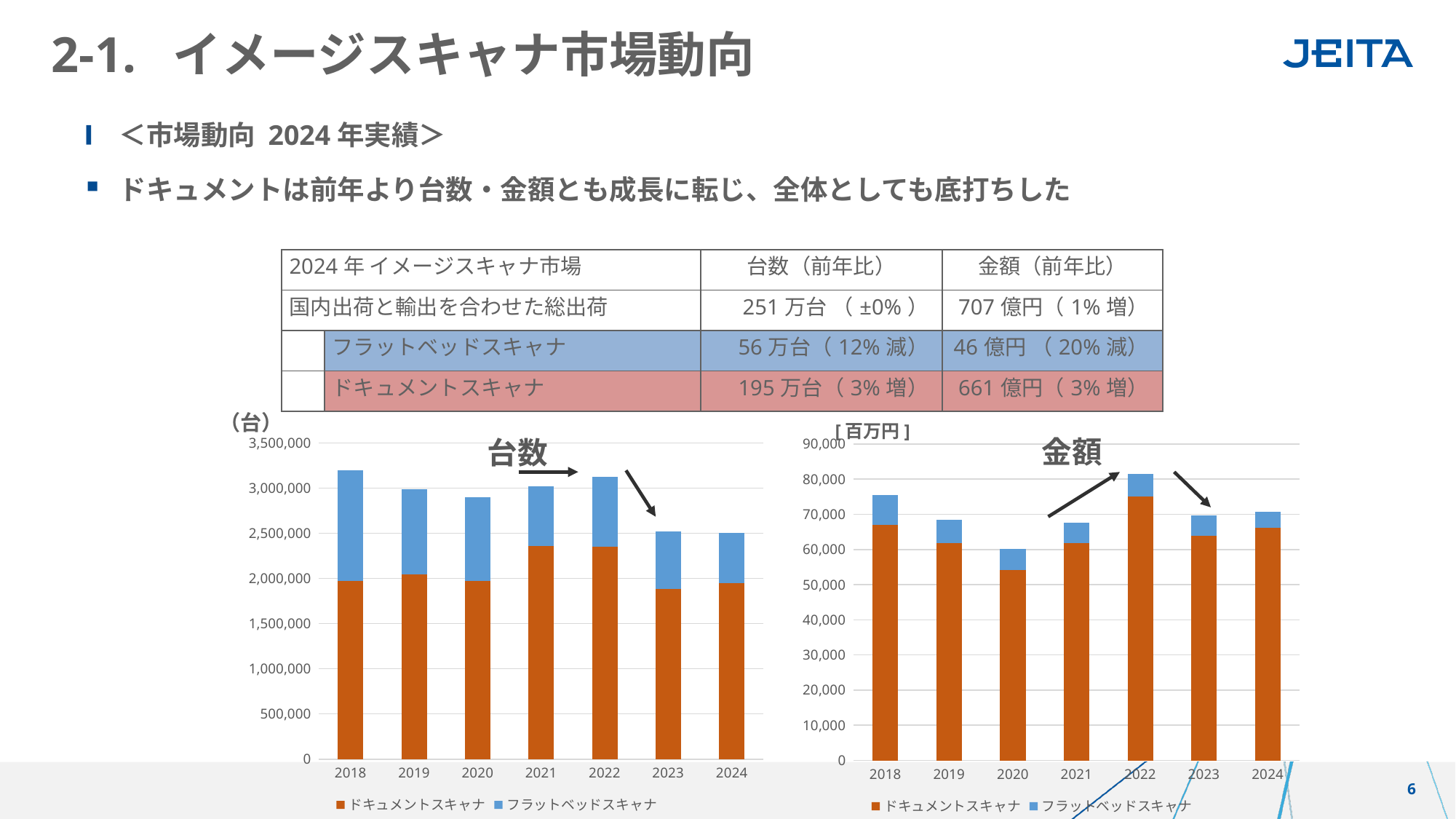
How many years are shown on the x axis of the 金額 chart on the right? 7 In the 金額 chart on the right, is the total for 2022 greater or less than 80,000? greater In the 台数 chart on the left, which year has the highest total bar? 2018 In the 金額 chart on the right, which year has the lowest total bar? 2020 In the 金額 chart on the right, is the total for 2020 greater or less than 70,000? less In the 台数 chart on the left, is the total for 2024 greater or less than 3,000,000? less What kind of chart is the 台数 chart on the left? stacked bar chart What unit is shown above the y axis of the 金額 chart on the right? 百万円 In the 金額 chart on the right, which year has the highest total bar? 2022 How many series does the legend of the 台数 chart list? 2 In the 金額 chart on the right, do the total bars rise or fall from 2020 to 2022? rise